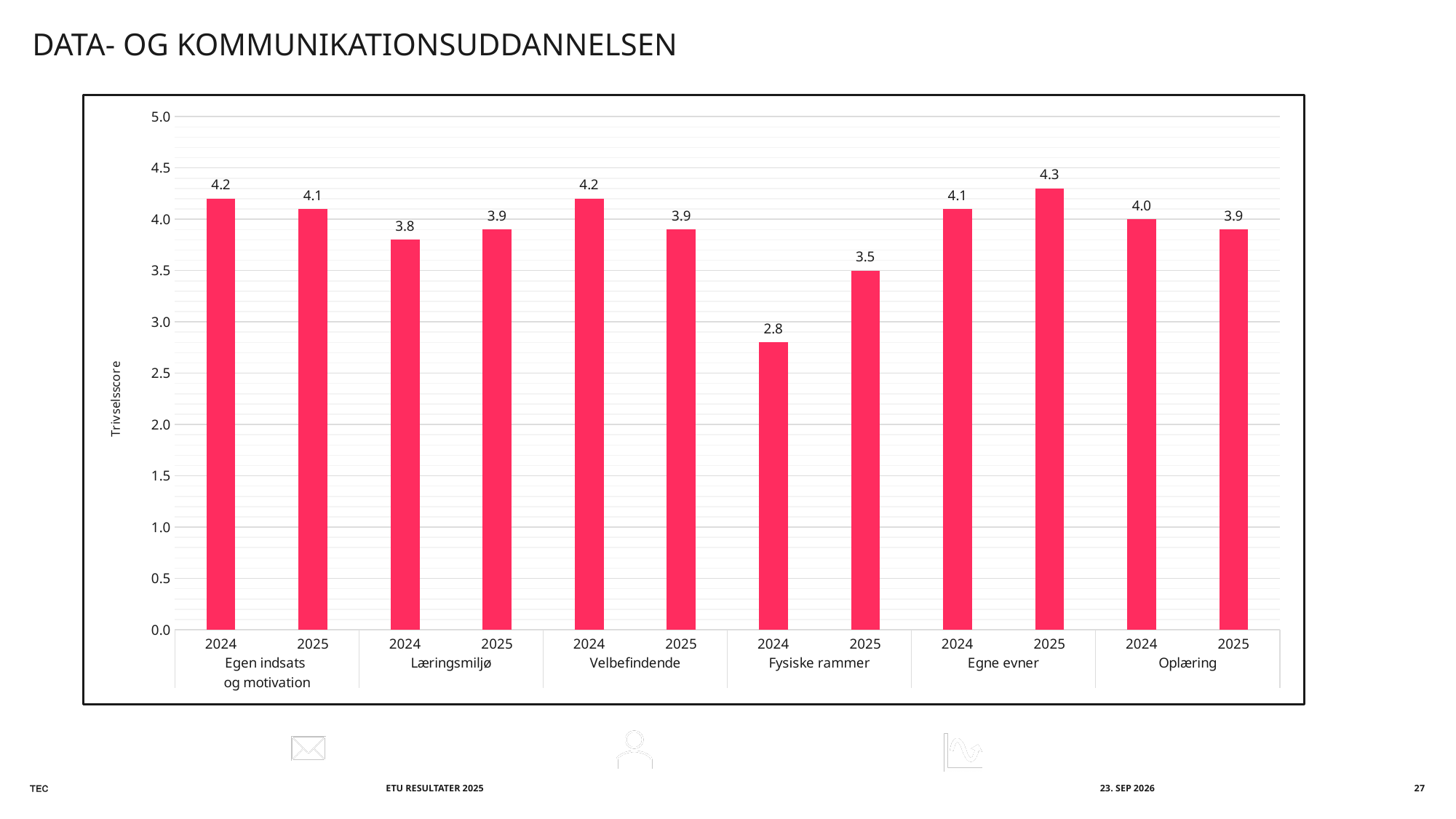
Which bar has the lowest Trivselsscore? Fysiske rammer 2024 What is the Trivselsscore for Fysiske rammer in 2024? 2.8 Is the 2024 Trivselsscore for Fysiske rammer greater or less than 3.0? less What is the difference between the 2025 and 2024 Trivselsscore for Fysiske rammer? 0.7 How many bars are plotted in the chart? 12 Which is larger, the 2024 or the 2025 Trivselsscore for Læringsmiljø? 2025 What kind of chart is shown on the slide? Bar chart What is the Trivselsscore for Oplæring in 2024? 4.0 What is the label of the vertical axis? Trivselsscore What is the difference between the 2024 and 2025 Trivselsscore for Velbefindende? 0.3 What is the Trivselsscore for Egne evner in 2025? 4.3 Which bar has the highest Trivselsscore? Egne evner 2025